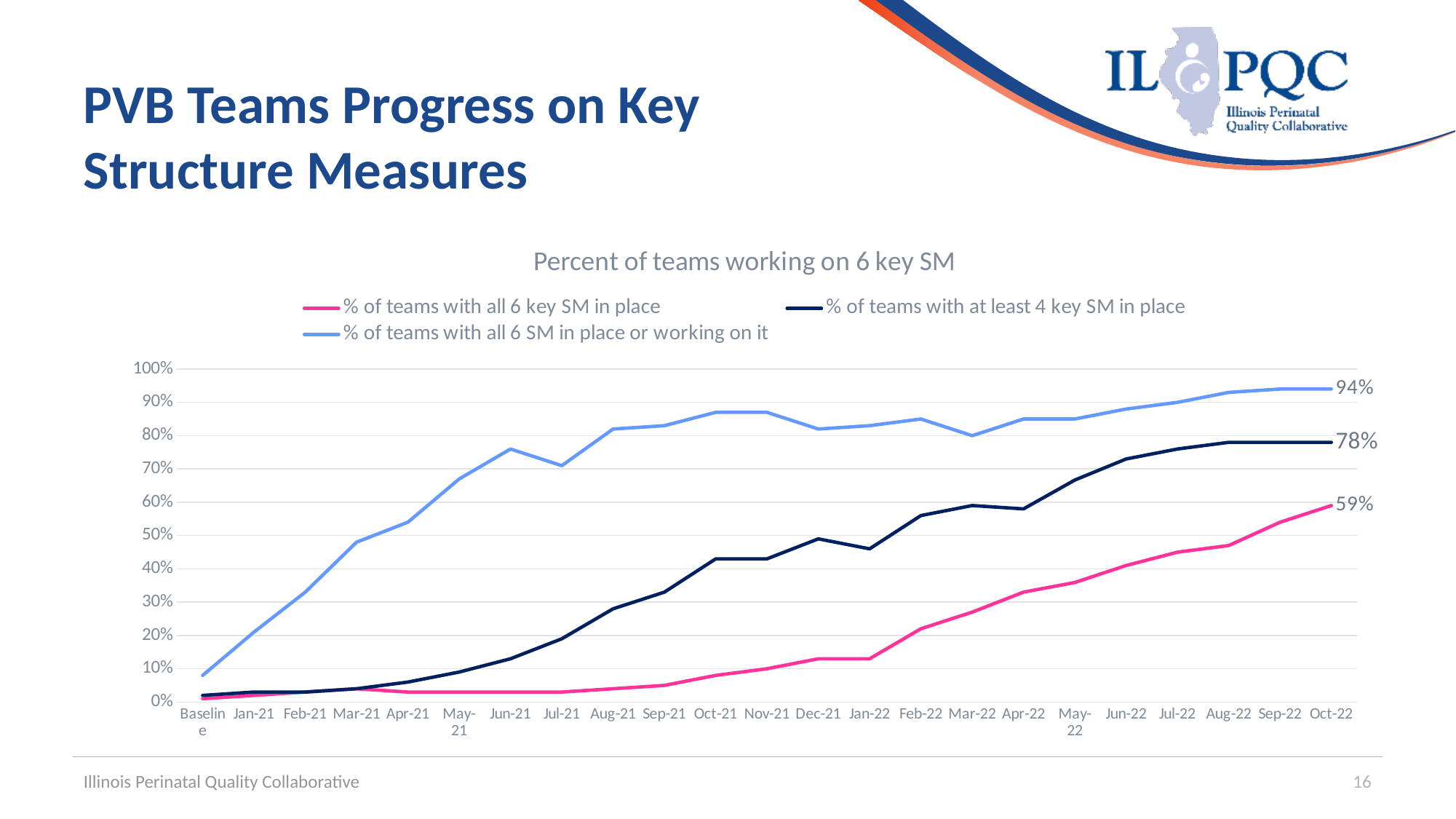
Which series has the highest value at Oct-22? % of teams with all 6 SM in place or working on it What is the value for '% of teams with all 6 key SM in place' at Oct-22? 59% Is the value for '% of teams with all 6 SM in place or working on it' at Jun-21 greater or less than 60%? greater What kind of chart is shown on the slide? line chart At Oct-22, what is the difference between '% of teams with all 6 SM in place or working on it' and '% of teams with all 6 key SM in place'? 35% What is the value for '% of teams with all 6 SM in place or working on it' at Oct-22? 94% How many series does the chart's legend list? 3 At Oct-22, what is the difference between '% of teams with at least 4 key SM in place' and '% of teams with all 6 key SM in place'? 19% What is the value for '% of teams with at least 4 key SM in place' at Oct-22? 78% What is the title of the chart? Percent of teams working on 6 key SM Which series has the lowest value at Oct-22? % of teams with all 6 key SM in place Does the '% of teams with all 6 key SM in place' series generally rise or fall from Baseline to Oct-22? rise